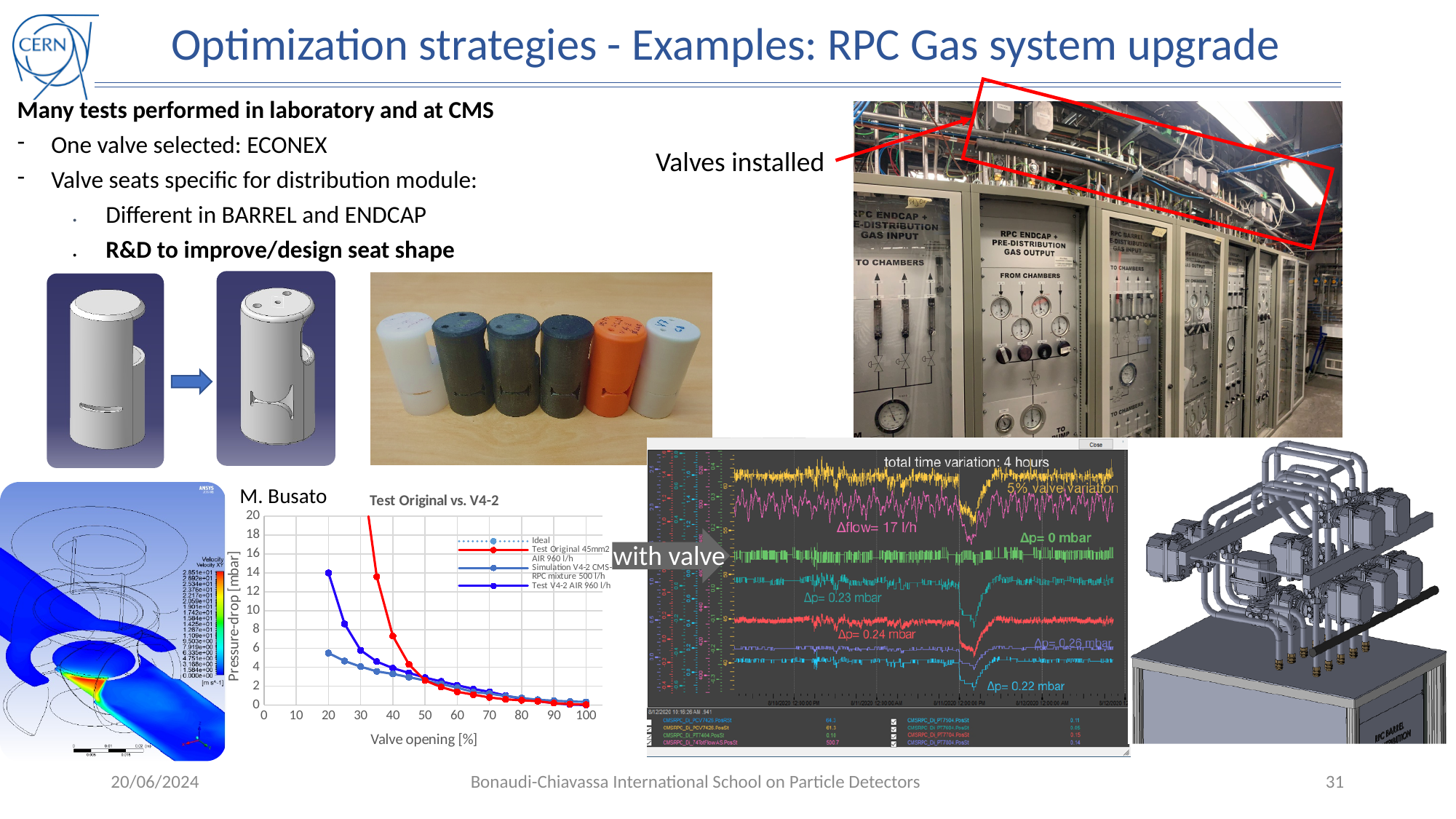
In the "Test Original vs. V4-2" chart, is the pressure drop of the Test V4-2 AIR 960 l/h series at 20% valve opening greater or less than 10 mbar? greater In the "Test Original vs. V4-2" chart, at 40% valve opening, which series has the larger pressure drop: Test Original 45mm2 AIR 960 l/h or Test V4-2 AIR 960 l/h? Test Original 45mm2 AIR 960 l/h In the "Test Original vs. V4-2" chart, is the pressure drop of the Test Original 45mm2 AIR 960 l/h series at 35% valve opening greater or less than 10 mbar? greater In the "Test Original vs. V4-2" chart, does the pressure drop rise or fall as the valve opening increases? Fall In the "Test Original vs. V4-2" chart, is the pressure drop of the Test V4-2 AIR 960 l/h series at 100% valve opening greater or less than 2 mbar? less What is the maximum value shown on the y axis of the "Test Original vs. V4-2" chart? 20 What kind of chart is "Test Original vs. V4-2"? Line chart In the "Test Original vs. V4-2" chart, what is the label of the x axis? Valve opening [%] How many series does the legend of the "Test Original vs. V4-2" chart list? 4 In the "Test Original vs. V4-2" chart, what is the label of the y axis? Pressure-drop [mbar] In the "Test Original vs. V4-2" chart, which series reaches the highest pressure drop shown on the plot? Test Original 45mm2 AIR 960 l/h